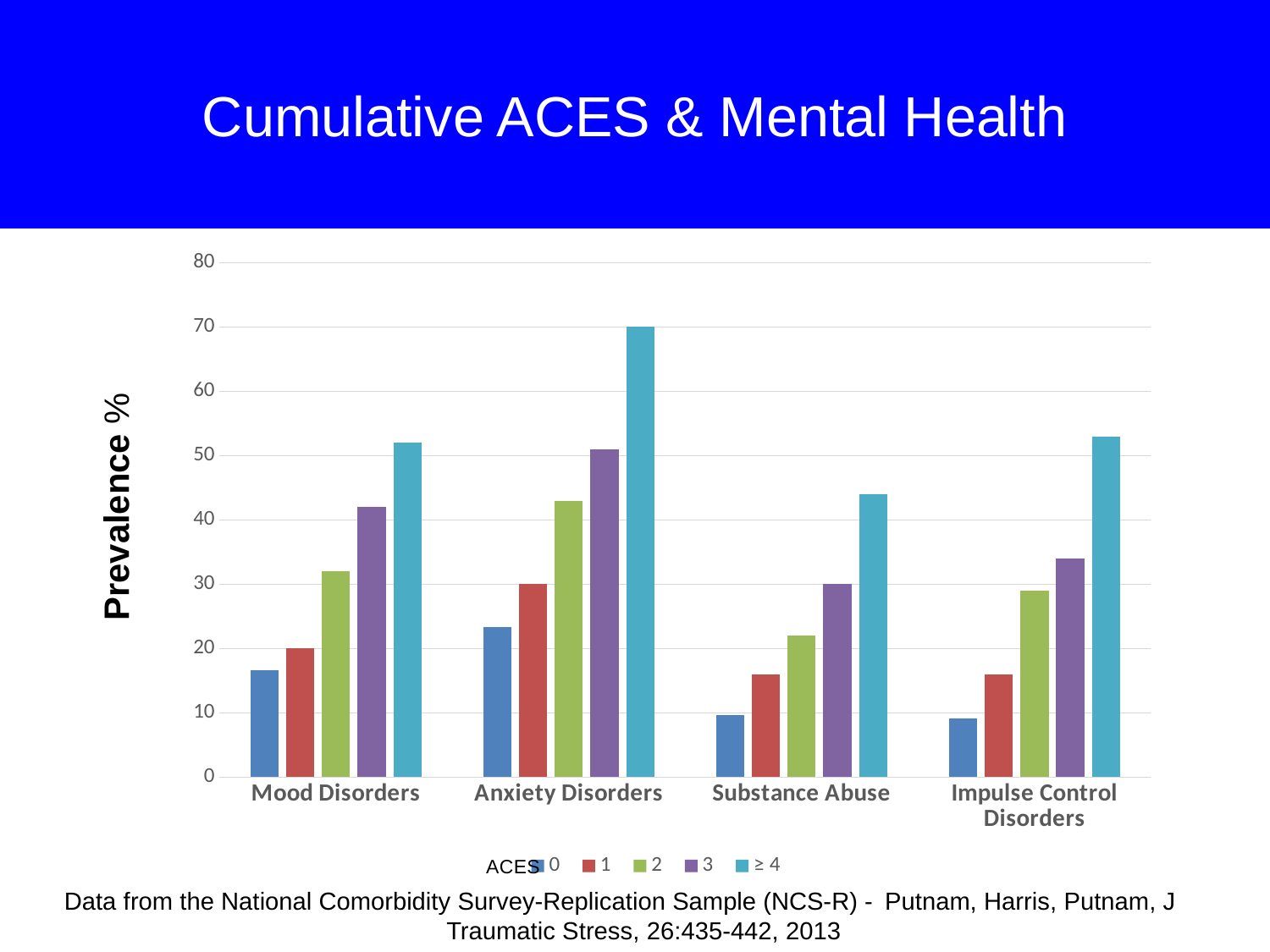
Within Substance Abuse, which ACES series has the lowest prevalence? 0 Within each disorder category, does prevalence rise or fall as the number of ACES increases? rise Is the value for Anxiety Disorders in the 2 ACES series greater or less than 40? greater Which disorder category has the highest prevalence for the ≥ 4 ACES series? Anxiety Disorders Which is larger: the 0 ACES value for Anxiety Disorders or the 0 ACES value for Mood Disorders? Anxiety Disorders Within Mood Disorders, which ACES series has the highest prevalence? ≥ 4 How many disorder categories are shown on the x axis? 4 What kind of chart is shown on the slide? bar chart What is the prevalence % for Anxiety Disorders in the ≥ 4 ACES series? 70 How many ACES series does the legend list? 5 Is the value for Mood Disorders in the ≥ 4 ACES series greater or less than 50? greater